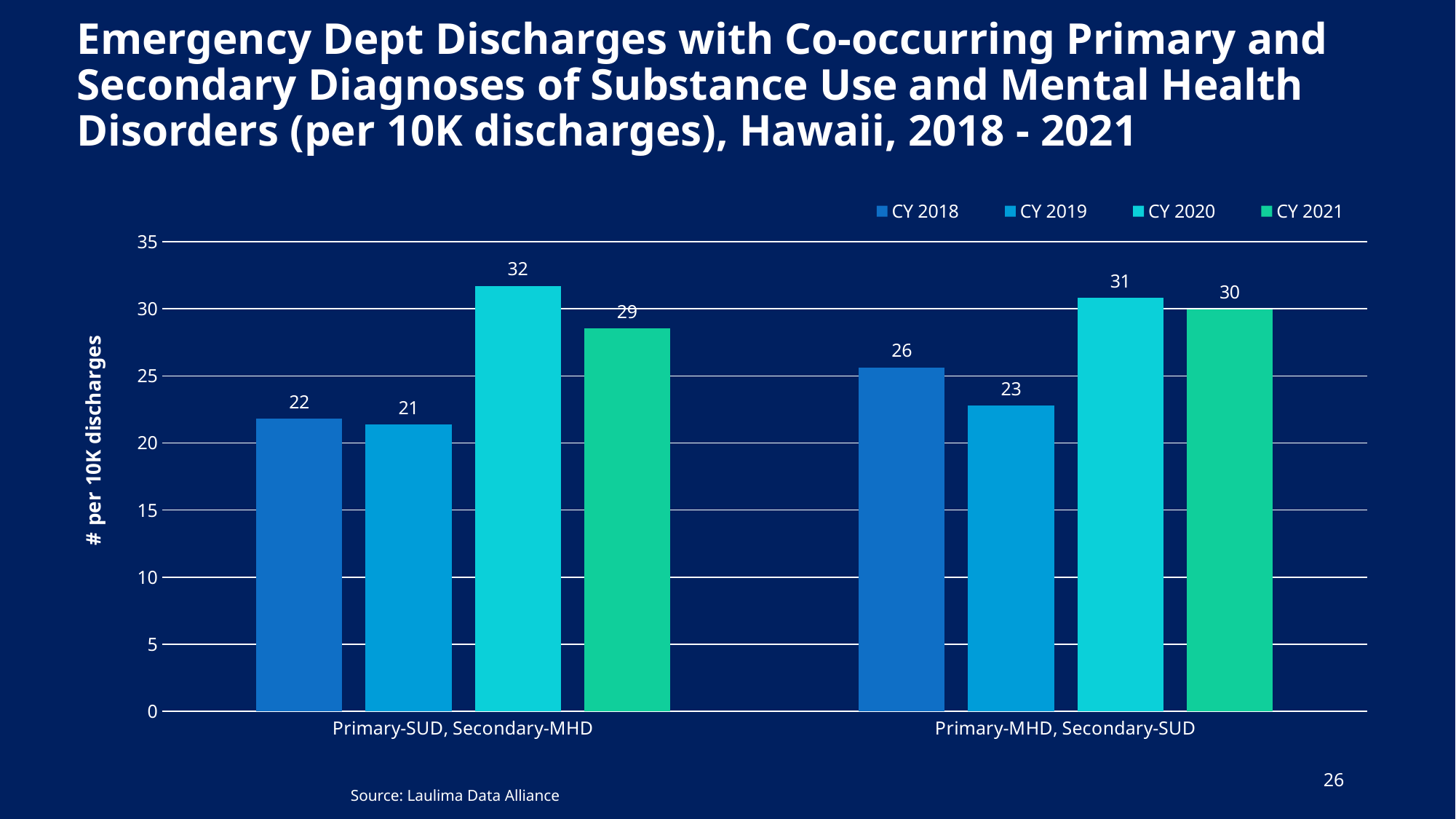
What is the label of the y axis? # per 10K discharges What is the difference between the CY 2020 and CY 2019 values in the Primary-SUD, Secondary-MHD category? 11 Which year has the lowest value in the Primary-SUD, Secondary-MHD category? CY 2019 Which year has the highest value in the Primary-MHD, Secondary-SUD category? CY 2020 What is the value for CY 2019 in the Primary-MHD, Secondary-SUD category? 23 How many series does the legend list? 4 What is the value for CY 2021 in the Primary-SUD, Secondary-MHD category? 29 Is the CY 2021 value for Primary-MHD, Secondary-SUD greater or less than 25? greater What kind of chart is shown on the slide? Bar chart Which is larger: the CY 2018 value for Primary-SUD, Secondary-MHD or the CY 2018 value for Primary-MHD, Secondary-SUD? Primary-MHD, Secondary-SUD What is the value for CY 2020 in the Primary-SUD, Secondary-MHD category? 32 How many categories are shown on the x axis? 2